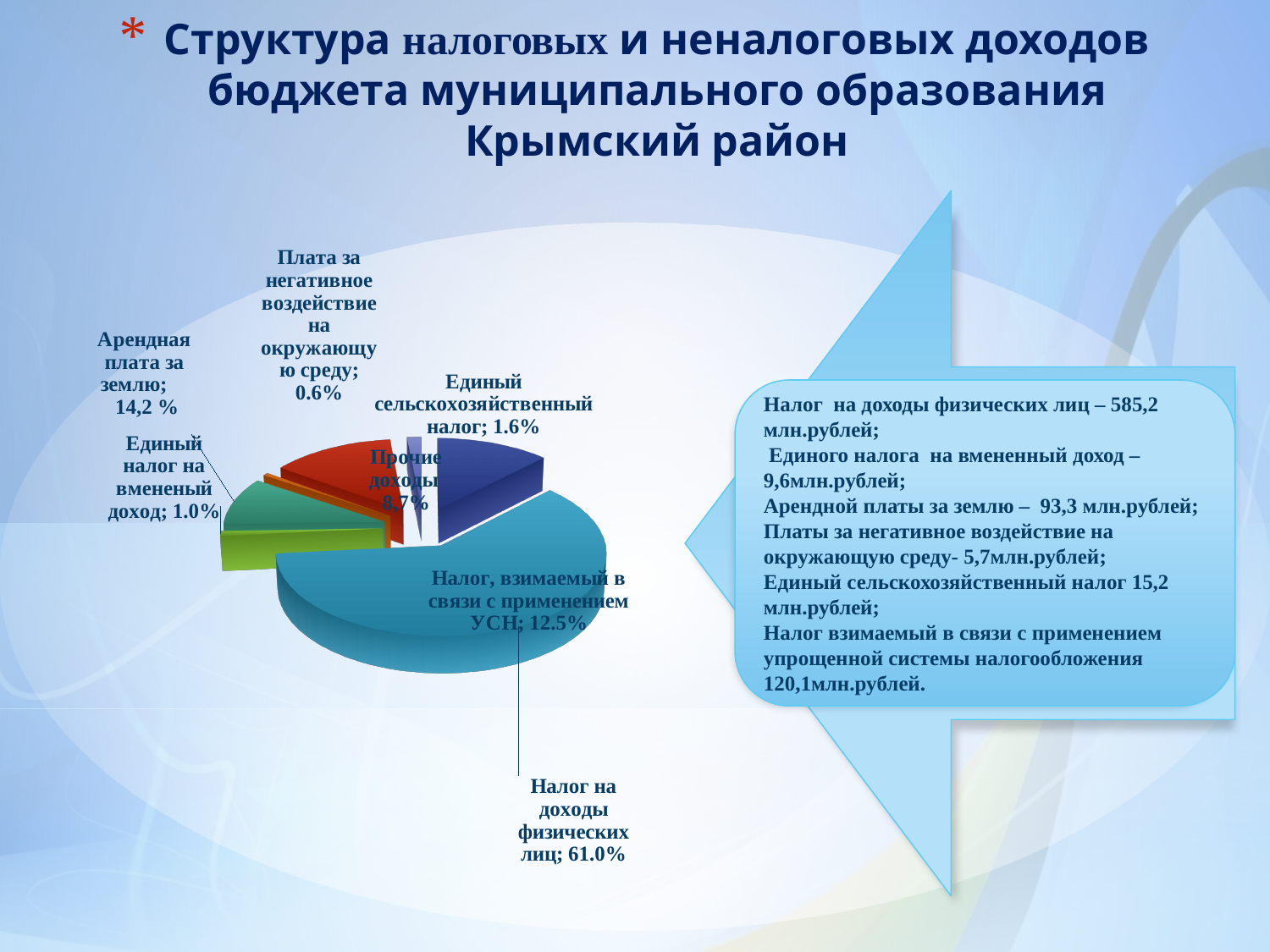
How many slices does the pie chart have? 7 Which slice of the pie is the largest? Налог на доходы физических лиц What share is shown for "Единый сельскохозяйственный налог"? 1.6% What share is shown for "Прочие доходы"? 8.7% Which slice of the pie is the smallest? Плата за негативное воздействие на окружающую среду What share is shown for "Единый налог на вмененый доход"? 1.0% What share is shown for "Налог, взимаемый в связи с применением УСН"? 12.5% What share of the pie does "Налог на доходы физических лиц" have? 61.0% Which is larger: the share for "Арендная плата за землю" or the share for "Налог, взимаемый в связи с применением УСН"? Арендная плата за землю What share is shown for "Арендная плата за землю"? 14,2 % What share is shown for "Плата за негативное воздействие на окружающую среду"? 0.6% What kind of chart is shown on the slide? pie chart